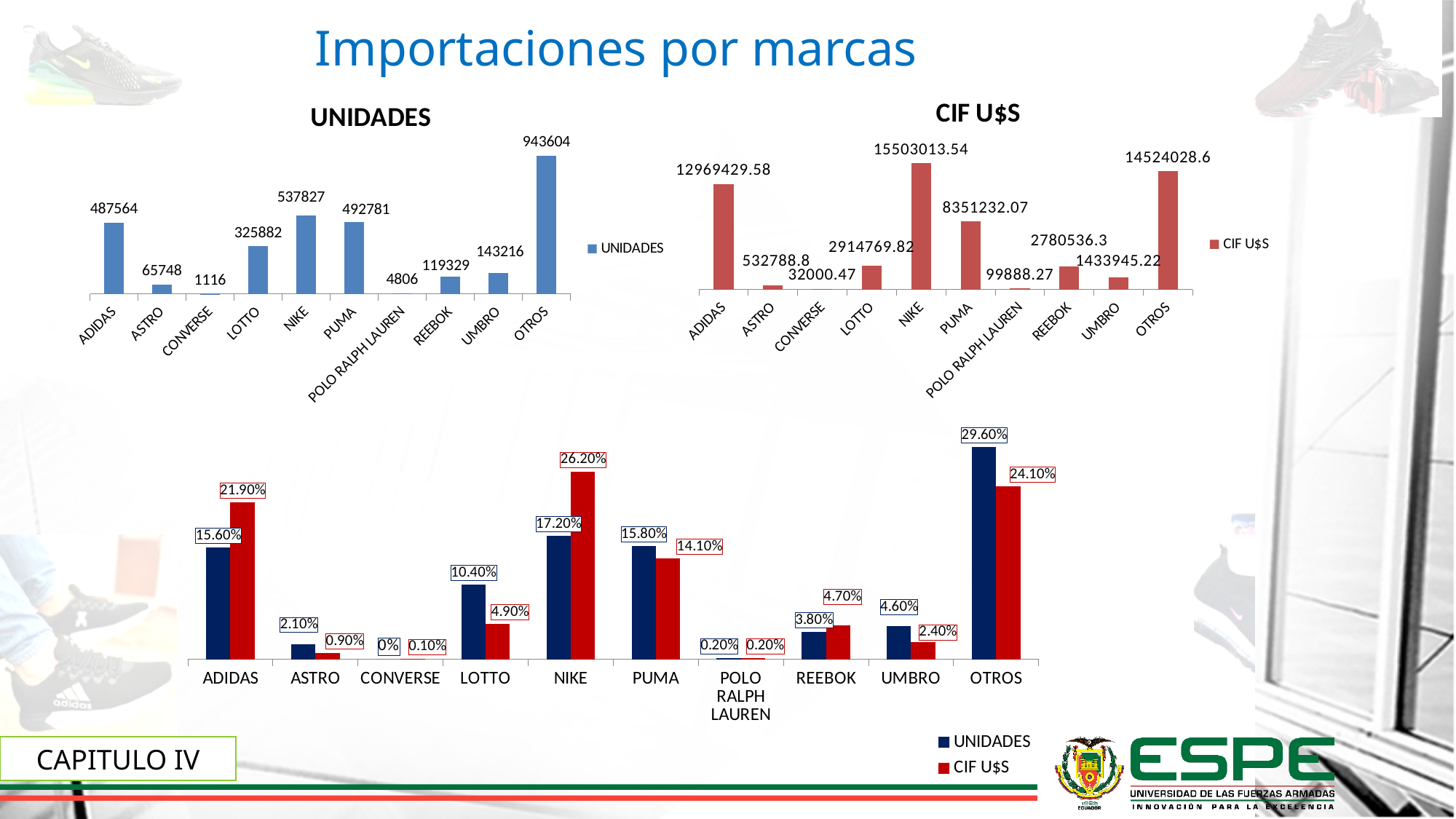
How many brands are shown on the x axis of the CIF U$S chart? 10 In the bottom chart, what is the UNIDADES percentage for LOTTO? 10.40% In the CIF U$S chart, which brand has the highest value? NIKE In the UNIDADES chart, which brand has the highest value? OTROS In the UNIDADES chart, which brand has the lowest value? CONVERSE In the bottom chart, what is the CIF U$S percentage for NIKE? 26.20% How many series does the legend of the bottom chart list? 2 In the bottom chart, what is the difference between the CIF U$S and UNIDADES percentages for ADIDAS? 6.30% In the CIF U$S chart, which is larger, the value for ADIDAS or the value for OTROS? OTROS In the UNIDADES chart, what is the value for NIKE? 537827 In the UNIDADES chart, what is the difference between the values for NIKE and PUMA? 45046 In the CIF U$S chart, what is the value for PUMA? 8351232.07